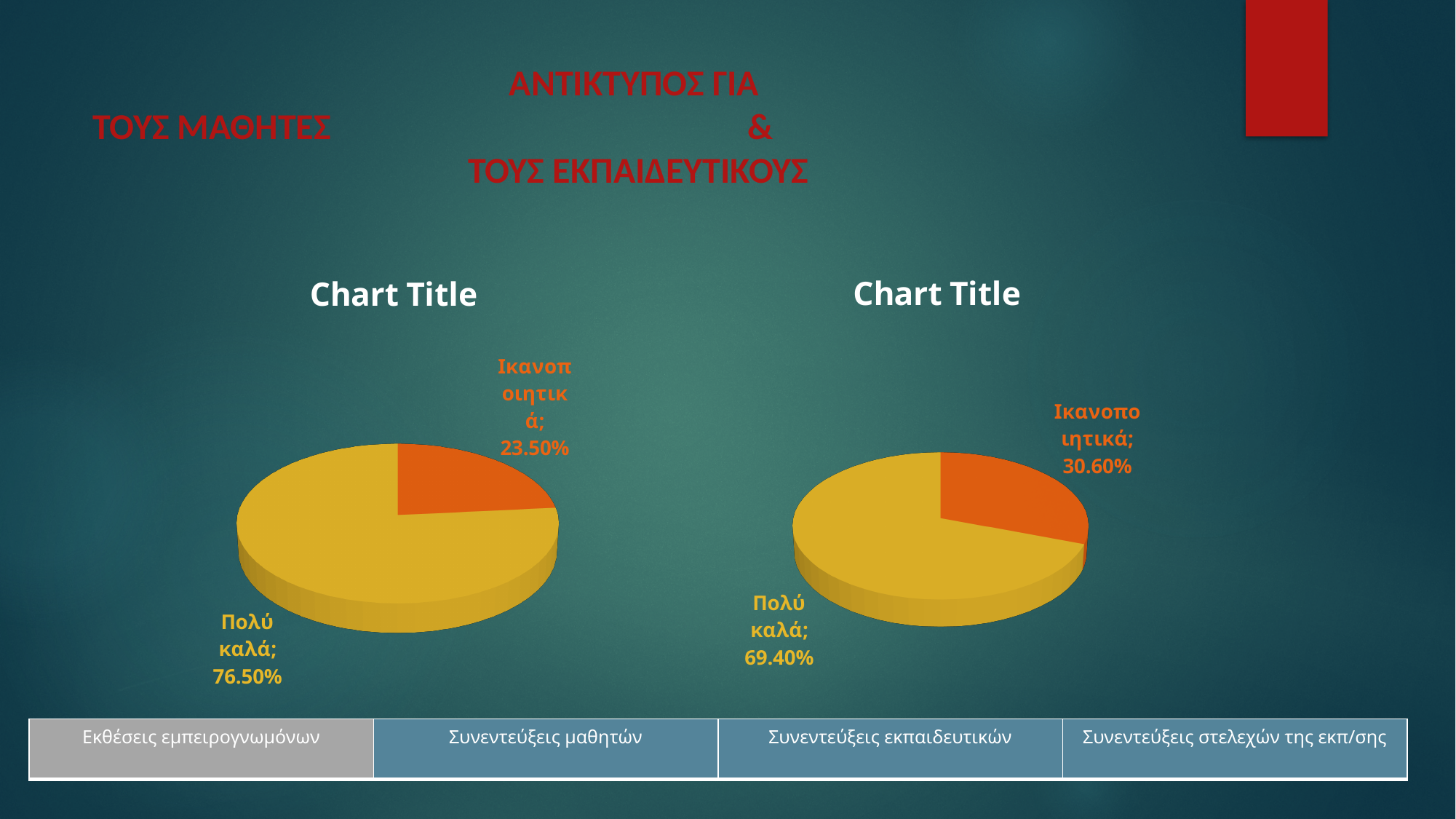
In the right pie chart, what is the value for Πολύ καλά? 69.40% In the right pie chart, which category has the smallest slice? Ικανοποιητικά Which chart has the larger value for Ικανοποιητικά, the left pie chart or the right pie chart? the right pie chart In the right pie chart, what is the difference between the Πολύ καλά and Ικανοποιητικά values? 38.80% In the left pie chart, what is the difference between the Πολύ καλά and Ικανοποιητικά values? 53.00% In the left pie chart, what is the value for Πολύ καλά? 76.50% What type of chart is the right chart on the slide? pie chart What colour is the Πολύ καλά slice in the left pie chart? yellow In the left pie chart, what is the value for Ικανοποιητικά? 23.50% In the right pie chart, what is the value for Ικανοποιητικά? 30.60% How many slices does the left pie chart have? 2 In the left pie chart, which category has the largest slice? Πολύ καλά